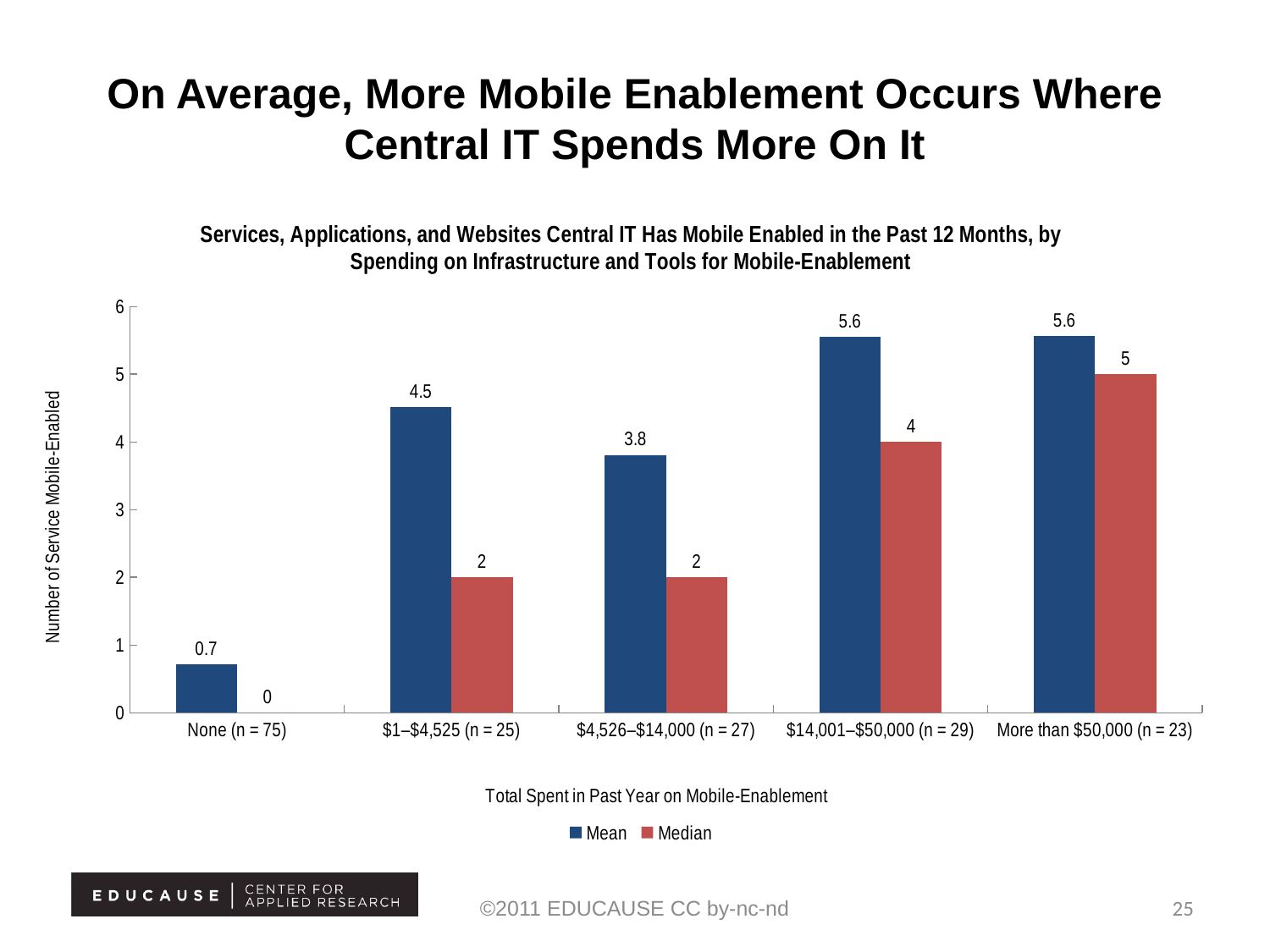
Which is larger, the Mean for $1–$4,525 (n = 25) or the Mean for $4,526–$14,000 (n = 27)? $1–$4,525 (n = 25) Which series is shown in red in the legend? Median What is the Mean value for the None (n = 75) category? 0.7 Which category has the lowest Median value? None (n = 75) What is the Mean value for the $1–$4,525 (n = 25) category? 4.5 What is the difference between the Mean and Median values for the $14,001–$50,000 (n = 29) category? 1.6 Which category has the highest Median value? More than $50,000 (n = 23) How many series does the legend list? 2 How many spending categories are shown on the x axis? 5 What kind of chart is shown on the slide? Bar chart What is the Median value for the More than $50,000 (n = 23) category? 5 What is the label of the y axis? Number of Service Mobile-Enabled